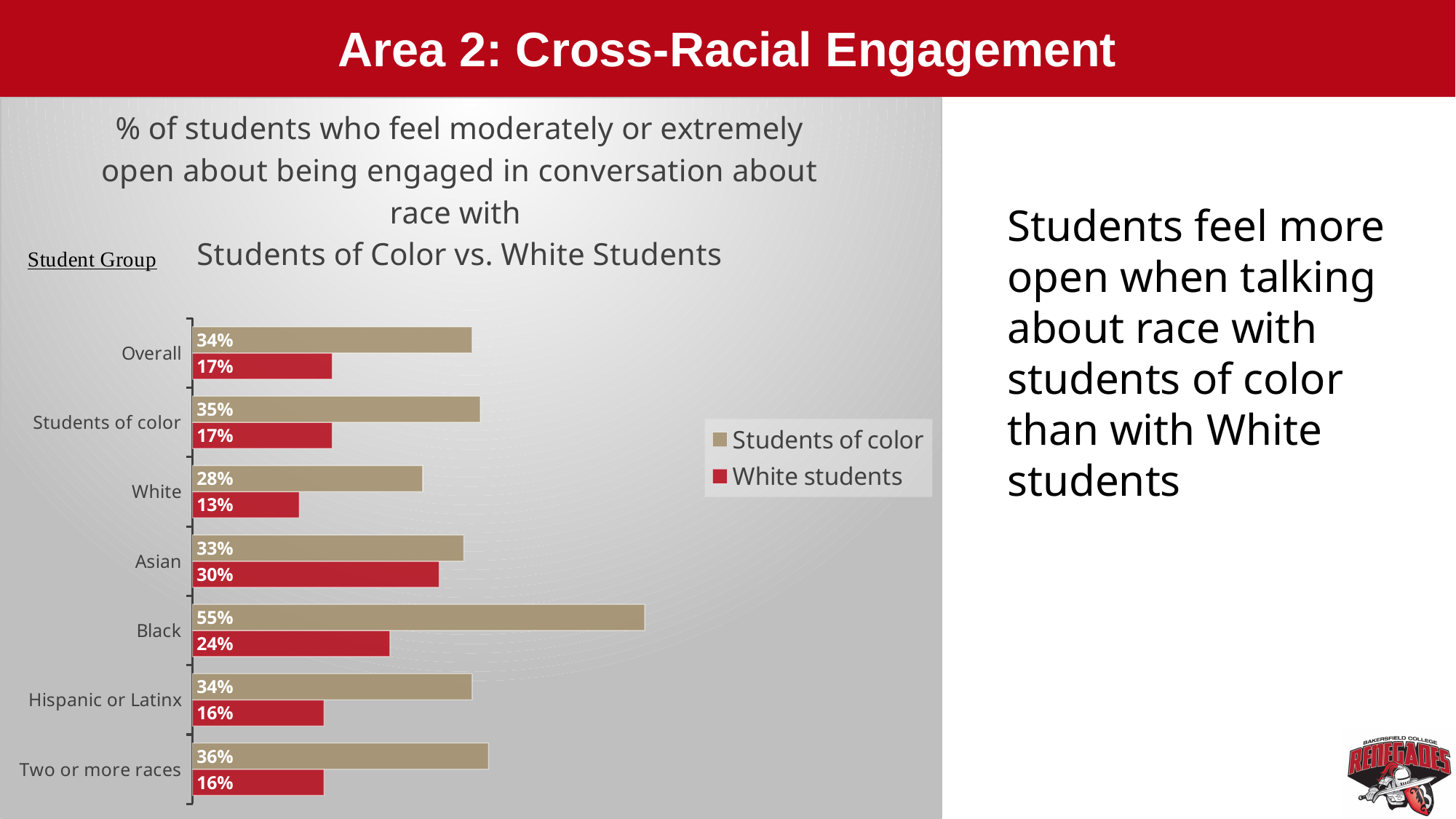
What kind of chart is shown on the slide? Bar chart Which student group has the highest value in the Students of color series? Black For the Asian group, which series has the larger value: Students of color or White students? Students of color Which colour represents the White students series in the legend? Red What is the value for Two or more races in the Students of color series? 36% How many series does the legend list? 2 What is the difference between the Students of color and White students values for the Black group? 31% What is the value for Asian students in the White students series? 30% What is the Overall value for the White students series? 17% Which student group has the lowest value in the White students series? White What is the value for Black students in the Students of color series? 55% How many student groups are shown on the chart? 7